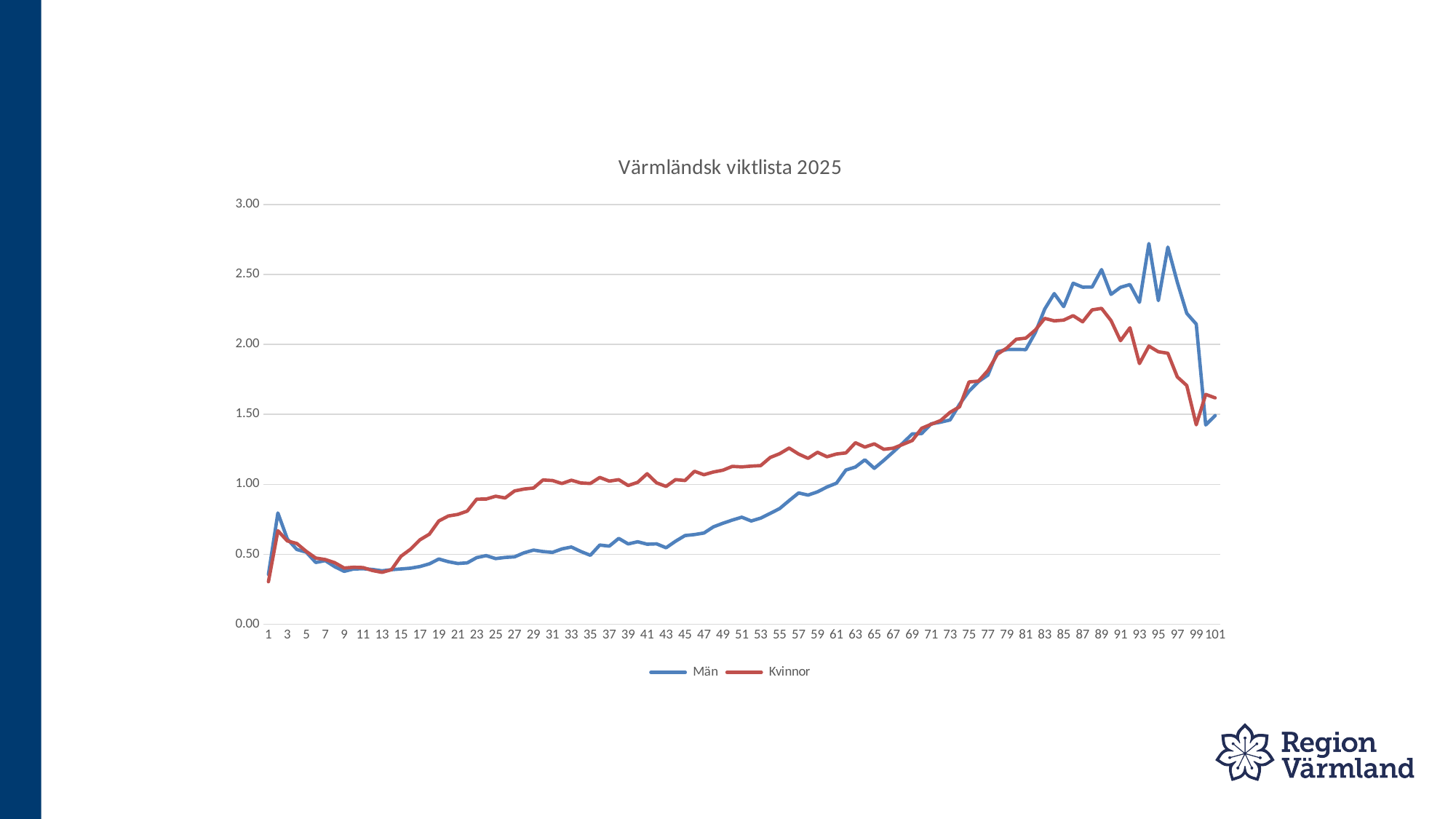
At x = 30, which series has the larger value, Män or Kvinnor? Kvinnor Does the Kvinnor line generally rise or fall between x = 13 and x = 89? rise At x = 94, which series has the larger value, Män or Kvinnor? Män How many series does the legend list? 2 Is the value for Kvinnor at x = 89 greater or less than 2.00? greater What is the title of the chart? Värmländsk viktlista 2025 Is the value for Män at x = 94 greater or less than 2.50? greater Is the value for Män at x = 20 greater or less than 0.50? less What kind of chart is shown on the slide? line chart Which series is drawn in red? Kvinnor